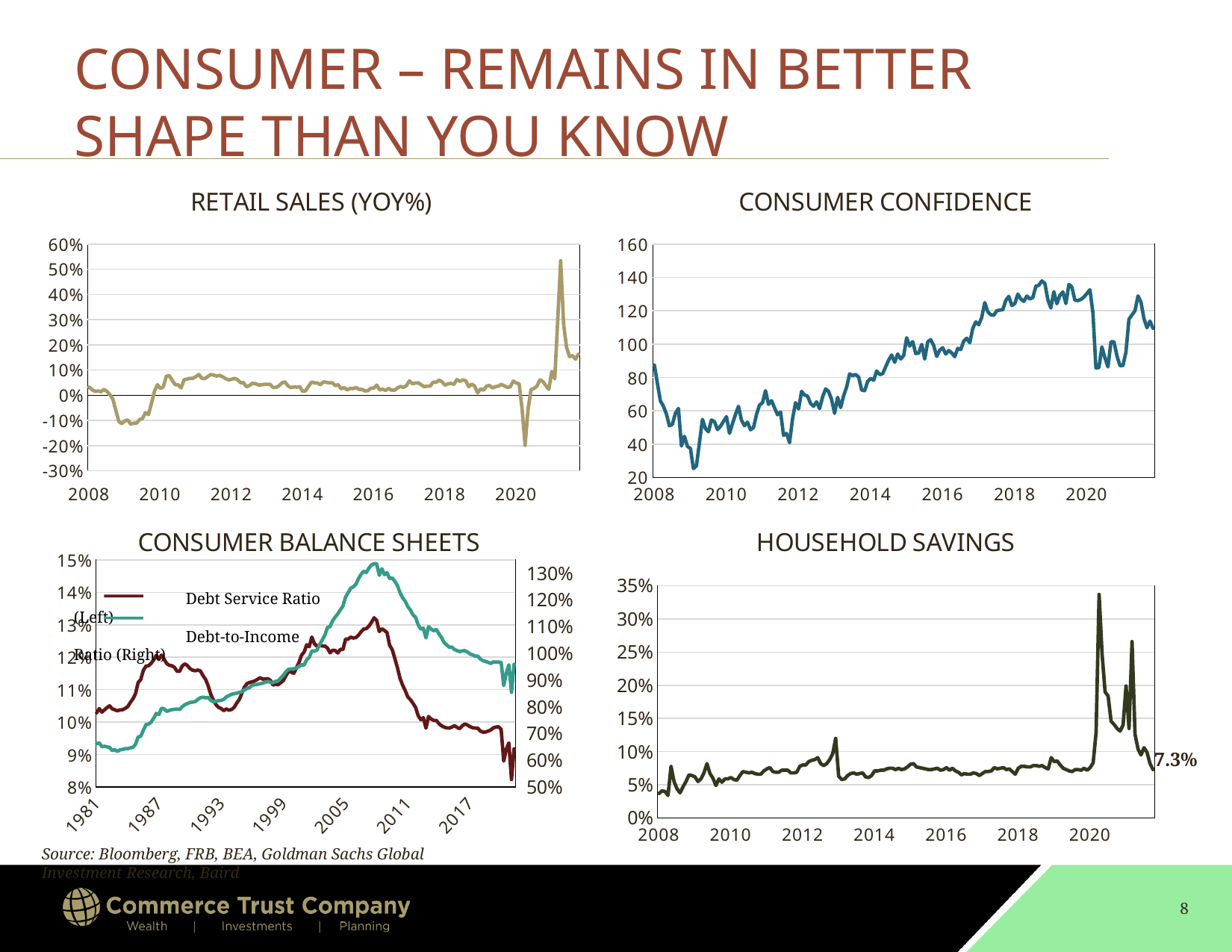
On the Consumer Confidence chart, does the line generally rise or fall between 2009 and 2018? rise On the Consumer Balance Sheets chart, is the peak of the Debt-to-Income Ratio greater or less than 120%? greater On the Household Savings chart, is the peak value reached in 2020 greater or less than 30%? greater On the Consumer Confidence chart, is the highest value reached around 2018 greater or less than 120? greater On the Household Savings chart, what is the value printed at the end of the line? 7.3% Which chart on the slide has a secondary (right-hand) value axis? Consumer Balance Sheets How many charts are shown on the slide? 4 What kind of chart is the Retail Sales (YoY%) chart? Line chart How many series does the legend of the Consumer Balance Sheets chart list? 2